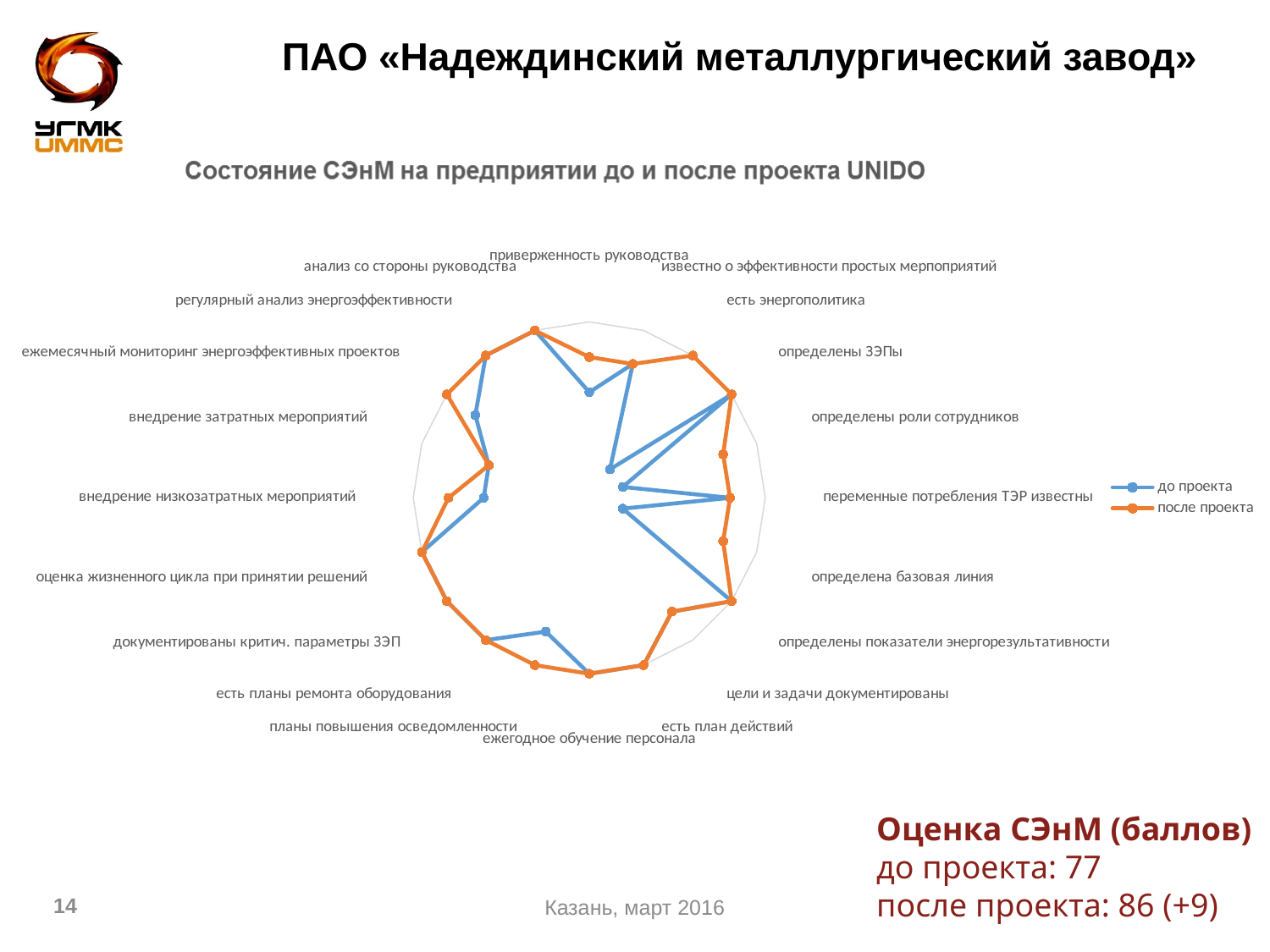
How many series does the chart legend list? 2 For the category "есть энергополитика", which series has the larger value: "до проекта" or "после проекта"? после проекта For the category "ежемесячный мониторинг энергоэффективных проектов", which series has the larger value: "до проекта" or "после проекта"? после проекта For the category "определена базовая линия", which series has the larger value: "до проекта" or "после проекта"? после проекта How many categories (axes) does the radar chart have? 20 What kind of chart is shown on the slide? radar chart What are the two series named in the chart legend? до проекта, после проекта What is the title of the chart? Состояние СЭнМ на предприятии до и после проекта UNIDO